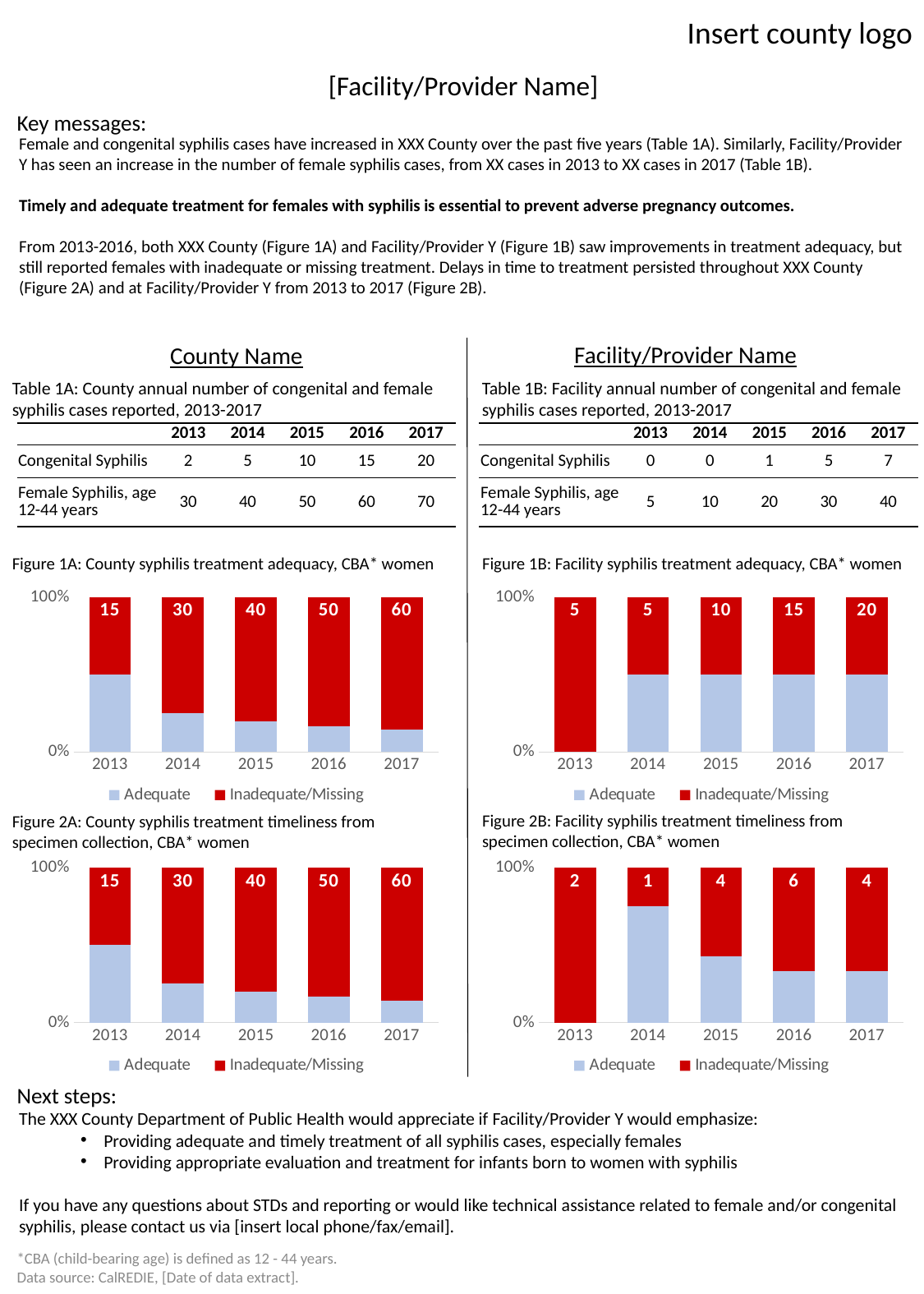
In Figure 2B (Facility syphilis treatment timeliness), which year has the lowest Inadequate/Missing data label? 2014 In Figure 1B (Facility syphilis treatment adequacy), what is the difference between the Inadequate/Missing data labels for 2017 and 2013? 15 How many years are shown on the x axis of Figure 1A (County syphilis treatment adequacy)? 5 In Figure 2A (County syphilis treatment timeliness), which year has the larger Inadequate/Missing data label, 2013 or 2014? 2014 In Figure 1B (Facility syphilis treatment adequacy), what is the data label on the Inadequate/Missing segment for 2015? 10 In Figure 2B (Facility syphilis treatment timeliness), which year has the highest Inadequate/Missing data label? 2016 What kind of chart is Figure 1B (Facility syphilis treatment adequacy)? Stacked bar chart In Figure 1A (County syphilis treatment adequacy), do the Inadequate/Missing data labels rise or fall from 2013 to 2017? Rise In Figure 2B (Facility syphilis treatment timeliness), what is the data label on the Inadequate/Missing segment for 2013? 2 In Figure 1A (County syphilis treatment adequacy), what is the data label on the Inadequate/Missing segment for 2017? 60 What are the two legend entries in Figure 2A (County syphilis treatment timeliness)? Adequate and Inadequate/Missing How many series does the legend of Figure 2B (Facility syphilis treatment timeliness) list? 2